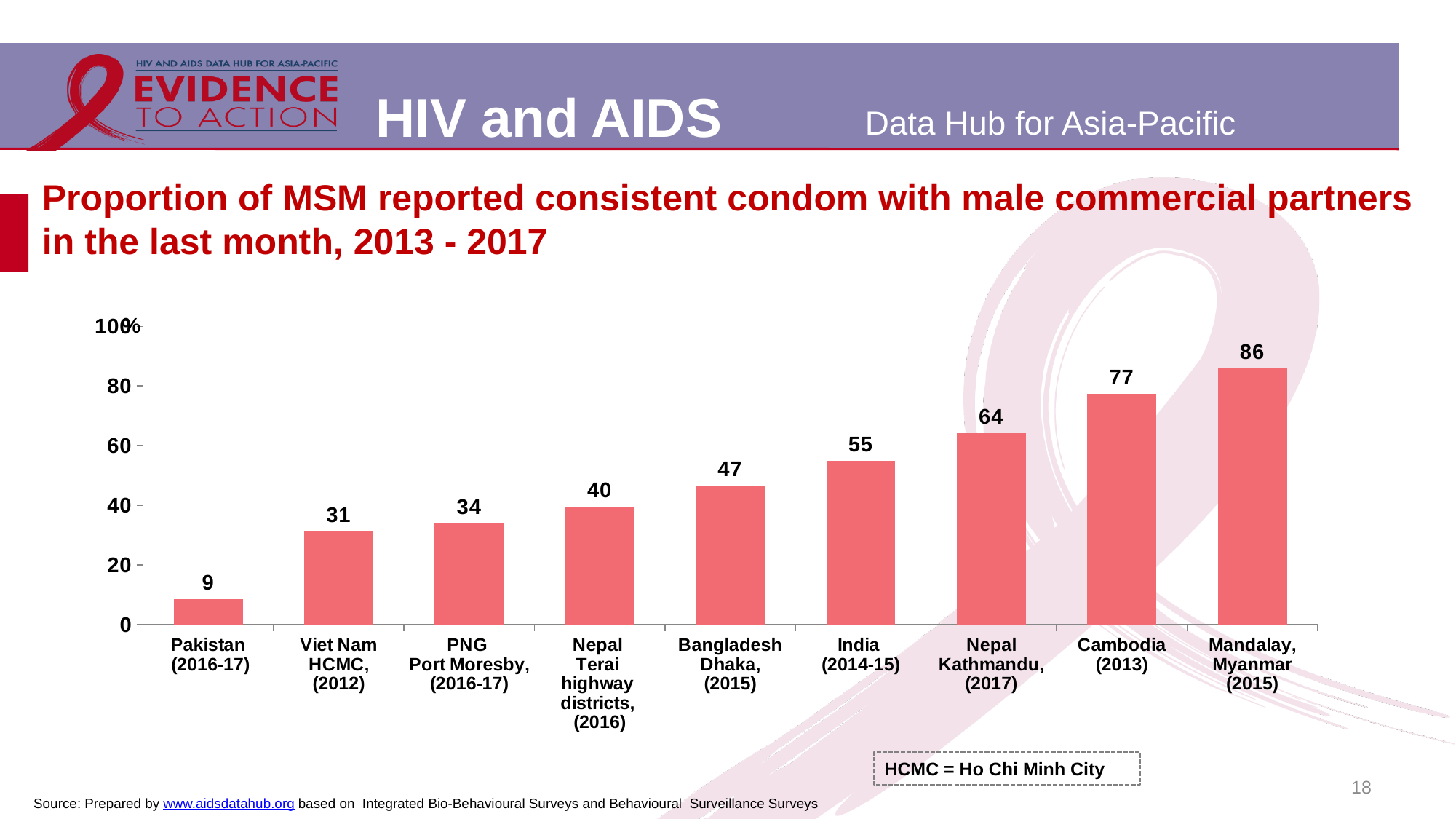
Which is larger, the value for Viet Nam HCMC (2012) or PNG Port Moresby (2016-17)? PNG Port Moresby (2016-17) What is the value for Bangladesh Dhaka (2015)? 47 Which category has the lowest value? Pakistan (2016-17) What kind of chart is shown on the slide? bar chart What does HCMC stand for according to the note on the slide? Ho Chi Minh City Is the value for Nepal Terai highway districts (2016) greater or less than 60? less What is the difference between the values for Cambodia (2013) and India (2014-15)? 22 Which category has the highest value? Mandalay, Myanmar (2015) How many categories are shown on the chart? 9 What is the value for Nepal Kathmandu (2017)? 64 What is the value for Pakistan (2016-17)? 9 Do the values rise or fall from left to right along the x axis? rise